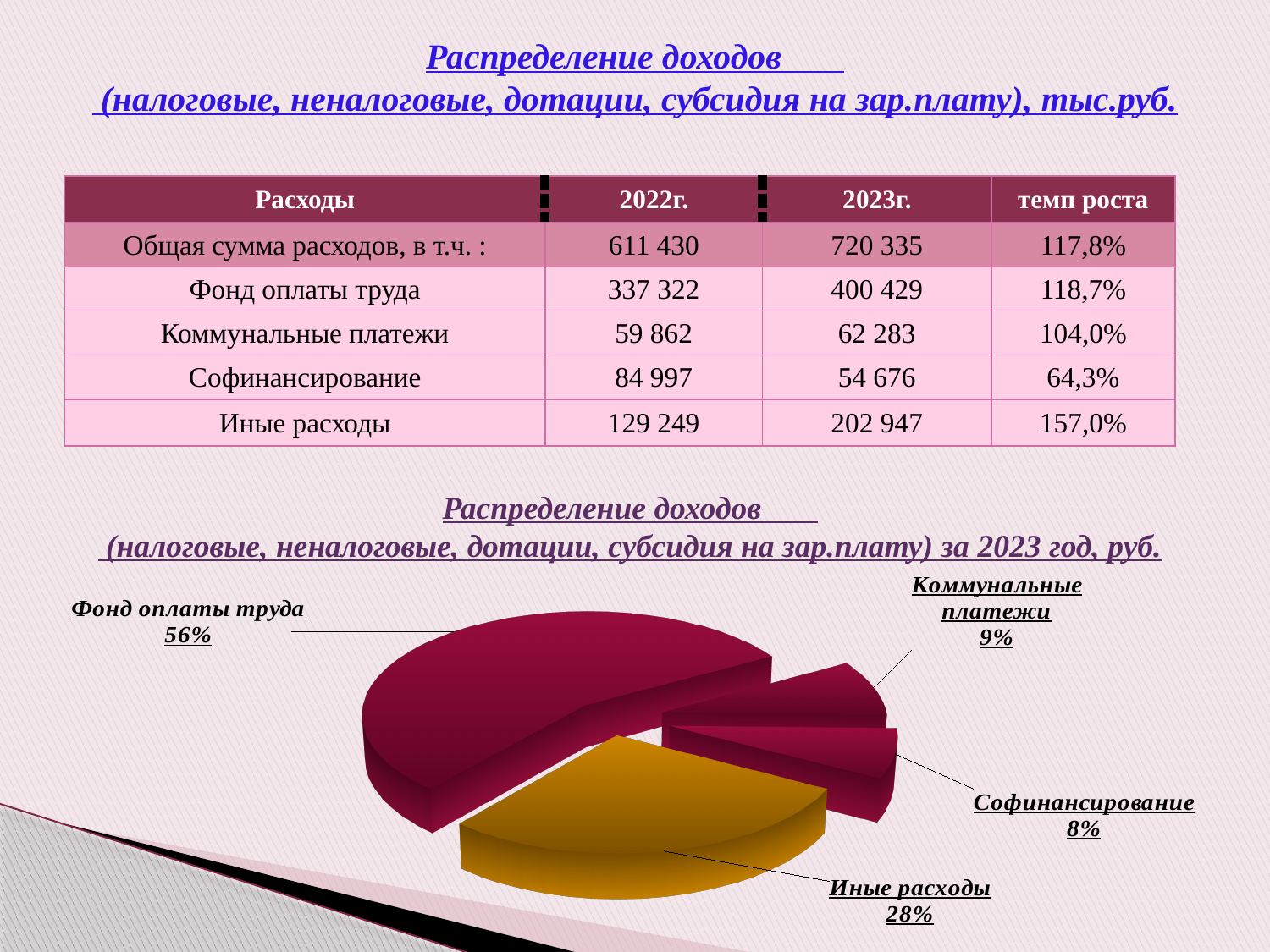
What share of the pie chart does Фонд оплаты труда take? 56% In the pie chart, which is larger: Иные расходы or Коммунальные платежи? Иные расходы What is the combined share of Коммунальные платежи and Софинансирование in the pie chart? 17% What colour is the Иные расходы slice in the pie chart? orange (gold) What percentage is shown for Софинансирование in the pie chart? 8% What share of the pie chart does Иные расходы take? 28% What kind of chart is shown at the bottom of the slide? pie chart How many slices does the pie chart have? 4 By how many percentage points does the Фонд оплаты труда slice exceed the Иные расходы slice? 28 percentage points What percentage is shown for Коммунальные платежи in the pie chart? 9% Which category has the largest slice in the pie chart? Фонд оплаты труда Which category has the smallest slice in the pie chart? Софинансирование